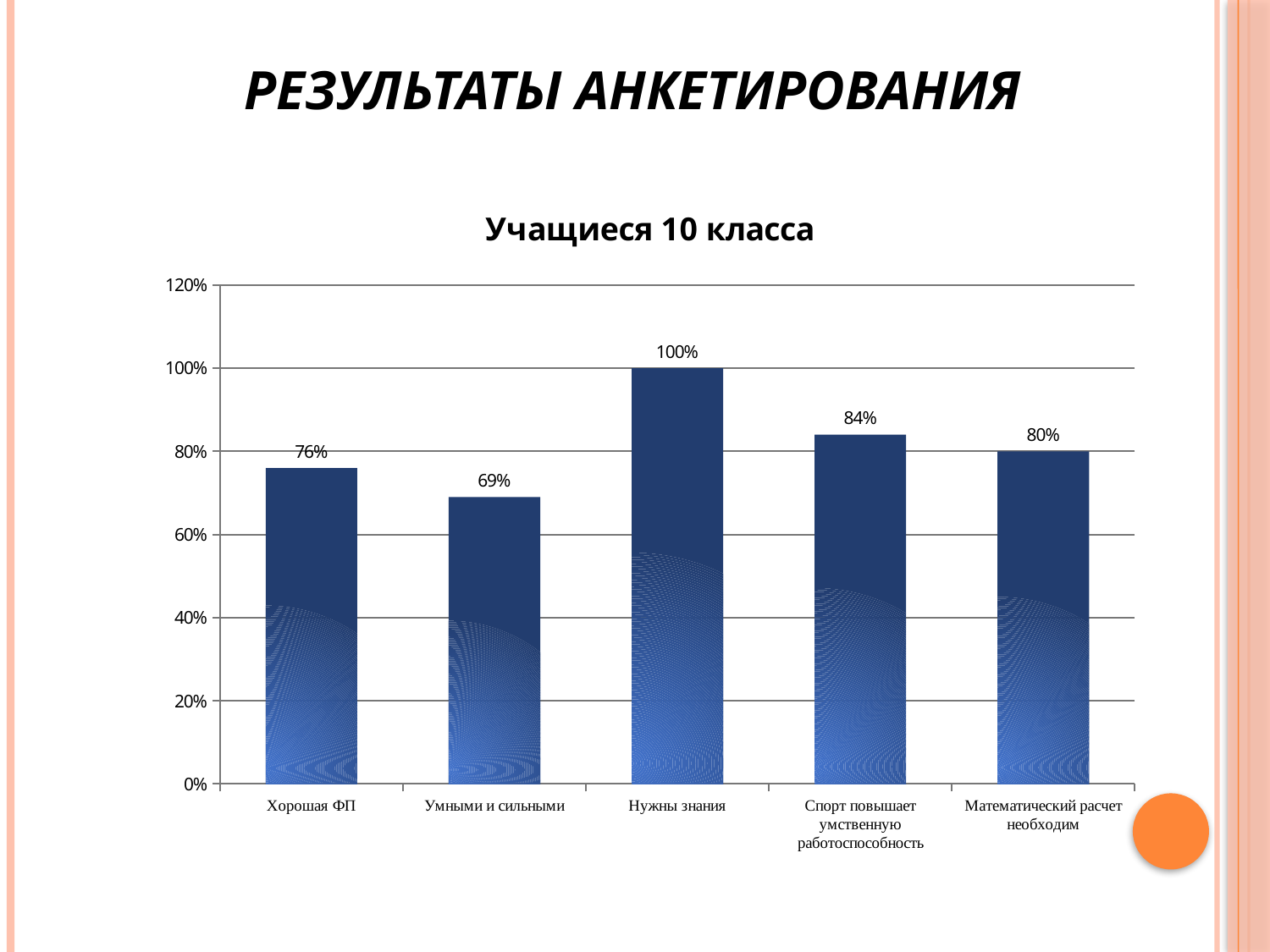
What is the value for Хорошая ФП? 76% What is the value for Умными и сильными? 69% Which category has the lowest value? Умными и сильными What kind of chart is shown on the slide? Bar chart How many categories are shown in the chart? 5 Which is larger, the value for Хорошая ФП or the value for Математический расчет необходим? Математический расчет необходим What is the value for Спорт повышает умственную работоспособность? 84% What is the value for Математический расчет необходим? 80% What is the difference between the values for Нужны знания and Умными и сильными? 31% What is the difference between the values for Спорт повышает умственную работоспособность and Хорошая ФП? 8% What is the title of the chart? Учащиеся 10 класса Which category has the highest value? Нужны знания